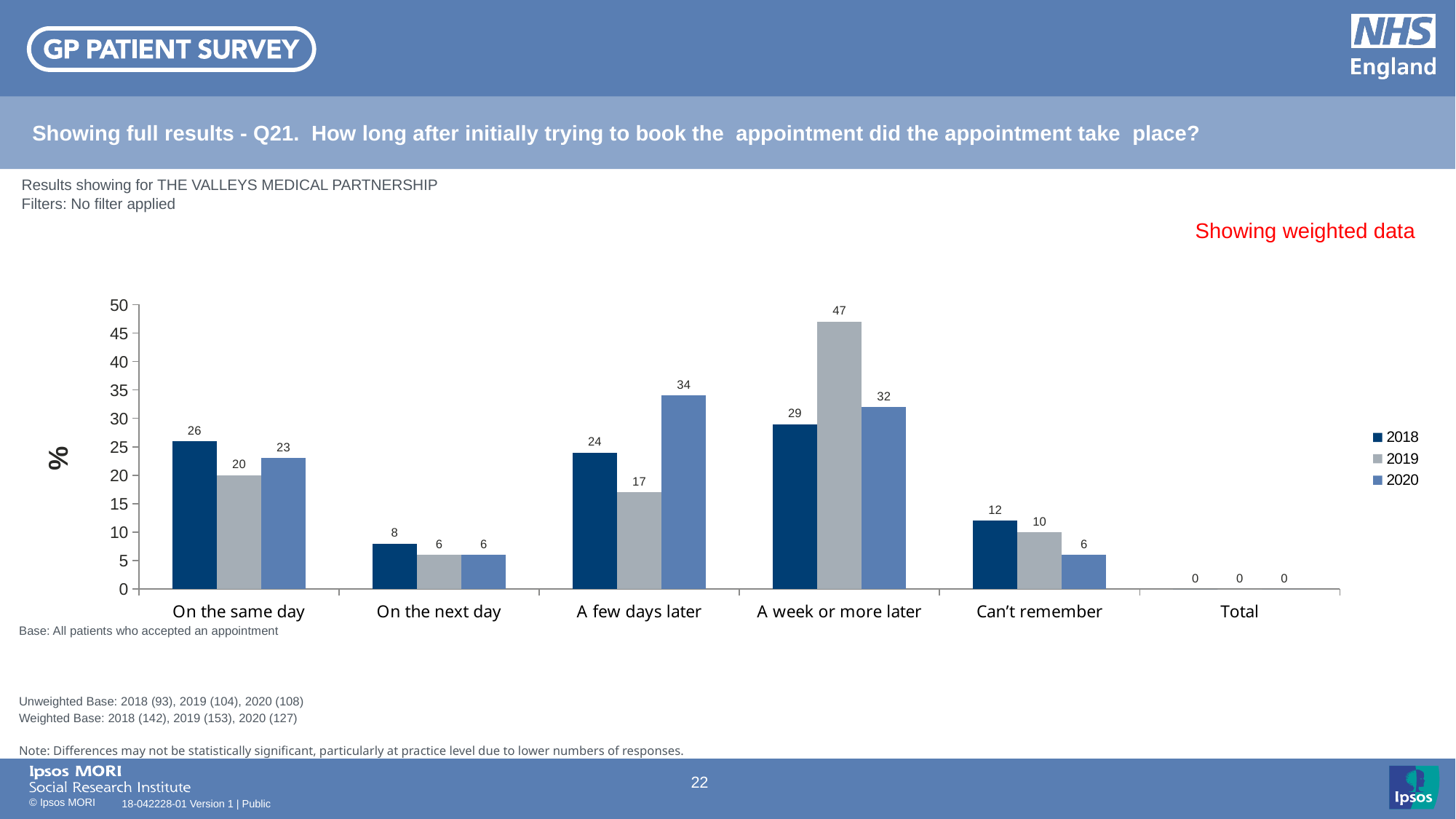
Which category has the highest 2020 value? A few days later What label is shown on the y axis? % What kind of chart is shown on the slide? Bar chart Which is larger for 'Can't remember': the 2018 value or the 2020 value? 2018 What is the 2019 value for 'A week or more later'? 47 Which category has the lowest 2018 value, excluding Total? On the next day What is the 2020 value for 'A few days later'? 34 Is the 2019 value for 'A week or more later' greater or less than 45? greater What is the difference between the 2019 and 2020 values for 'A week or more later'? 15 What is the 2018 value for 'On the same day'? 26 How many series does the legend list? 3 How many categories are shown on the x axis? 6